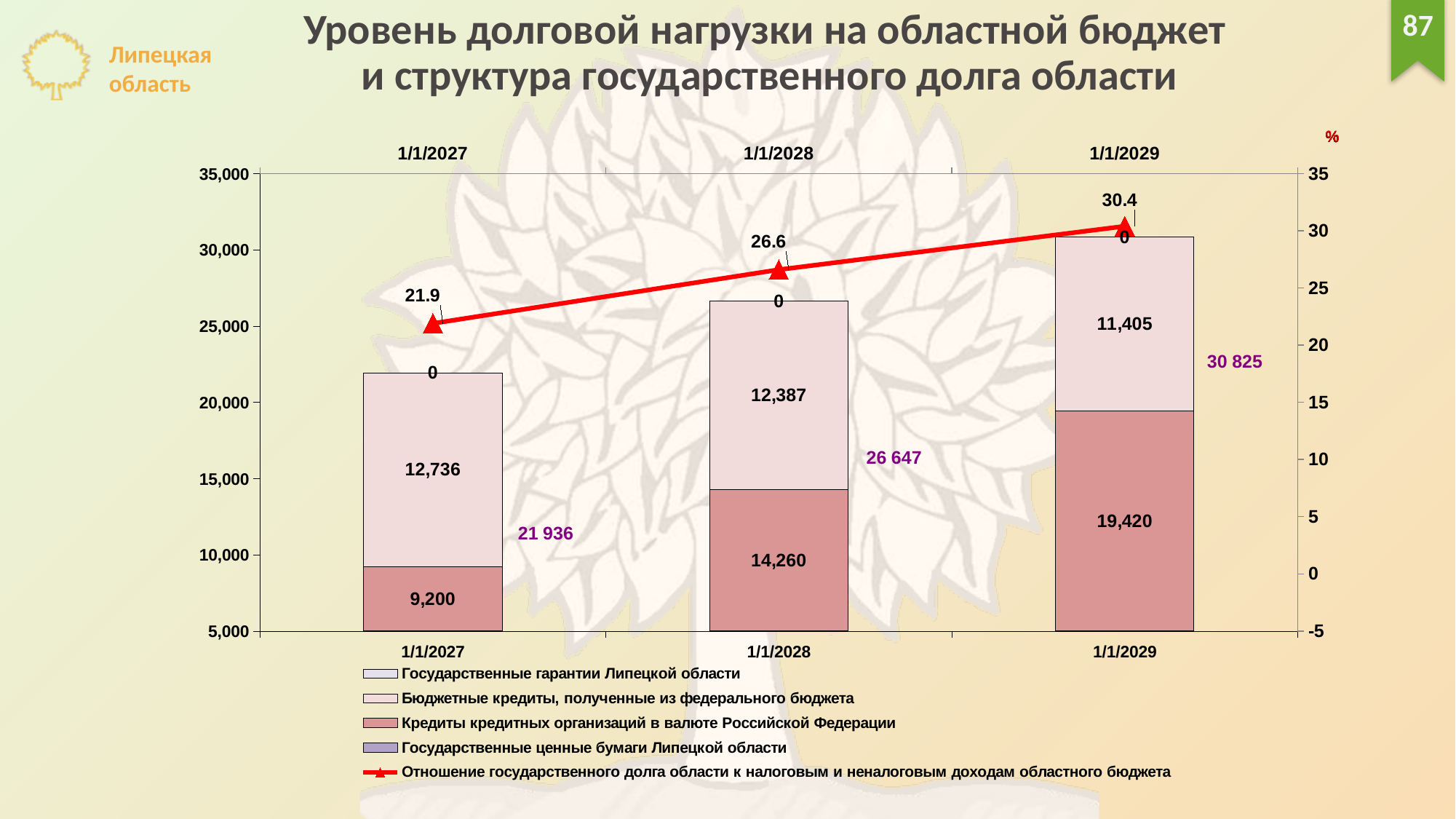
What is the value of the line Отношение государственного долга области к налоговым и неналоговым доходам областного бюджета on 1/1/2028? 26.6 What is the value of Кредиты кредитных организаций в валюте Российской Федерации on 1/1/2027? 9,200 Does the debt ratio line rise or fall from 1/1/2027 to 1/1/2029? rise What is the total of the stacked bar for 1/1/2028? 26 647 Which is larger on 1/1/2028: Бюджетные кредиты, полученные из федерального бюджета or Кредиты кредитных организаций в валюте Российской Федерации? Кредиты кредитных организаций в валюте Российской Федерации On which date is the value of Бюджетные кредиты, полученные из федерального бюджета lowest? 1/1/2029 How many dates are shown on the x axis? 3 What kind of chart is shown on the slide? stacked bar chart with a line What is the value of Бюджетные кредиты, полученные из федерального бюджета on 1/1/2029? 11,405 On which date is the value of Кредиты кредитных организаций в валюте Российской Федерации highest? 1/1/2029 How many entries does the legend list? 5 What is the difference between the Кредиты кредитных организаций values on 1/1/2029 and 1/1/2027? 10,220